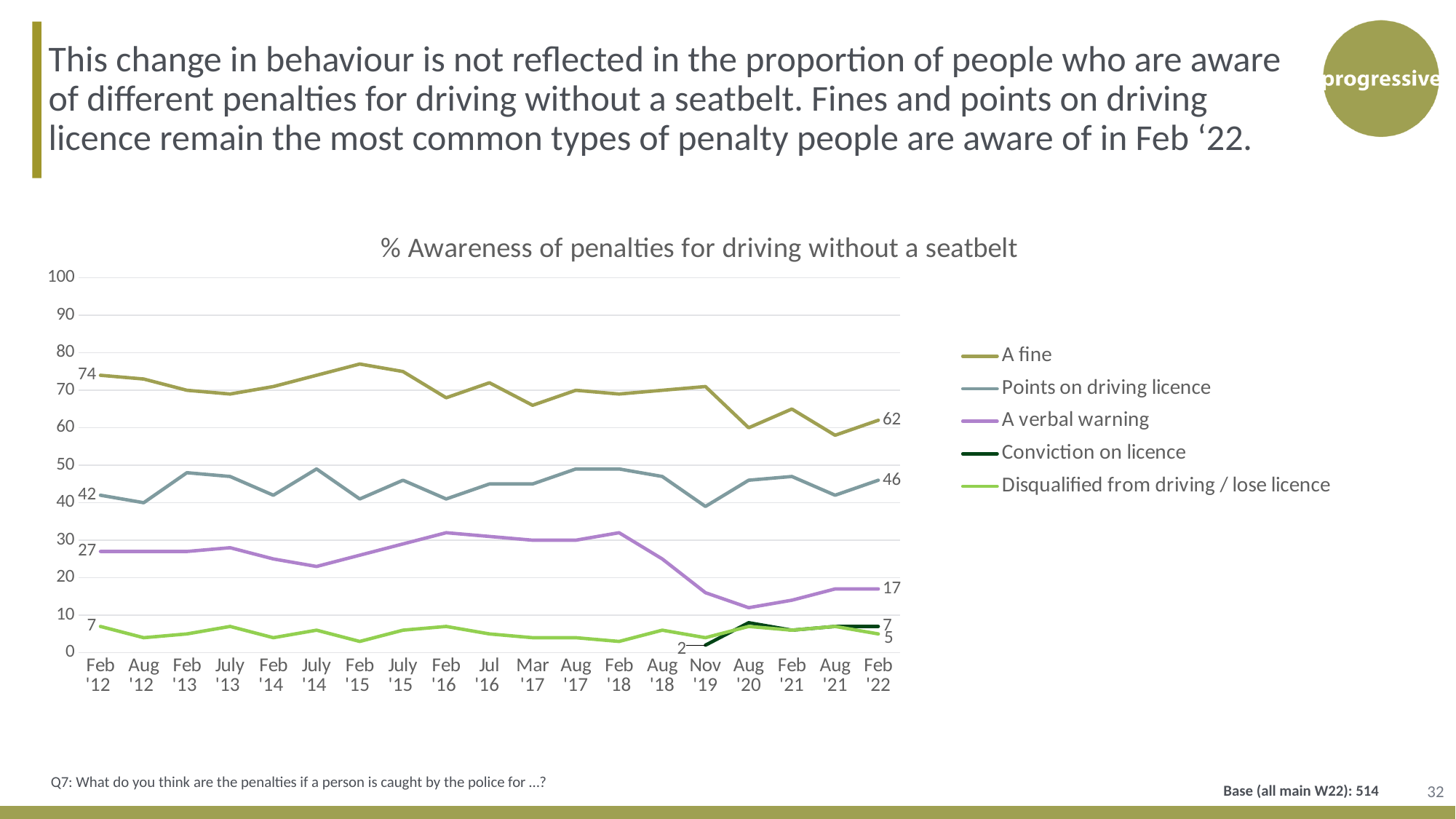
What is the value for 'A fine' in Feb '22? 62 What kind of chart is shown on the slide? Line chart What is the value for 'A verbal warning' in Feb '22? 17 What is the difference between 'A fine' and 'Points on driving licence' in Feb '22? 16 What is the value for 'Points on driving licence' in Feb '12? 42 Which series has the highest value in Feb '22? A fine By how much did the value for 'A fine' change between Feb '12 and Feb '22? 12 Is the value for 'A verbal warning' in Aug '20 greater or less than 20? less What is the value for 'Conviction on licence' in Nov '19? 2 What is the value for 'Disqualified from driving / lose licence' in Feb '22? 5 Which is larger in Feb '22: 'Points on driving licence' or 'A verbal warning'? Points on driving licence How many series does the legend list? 5